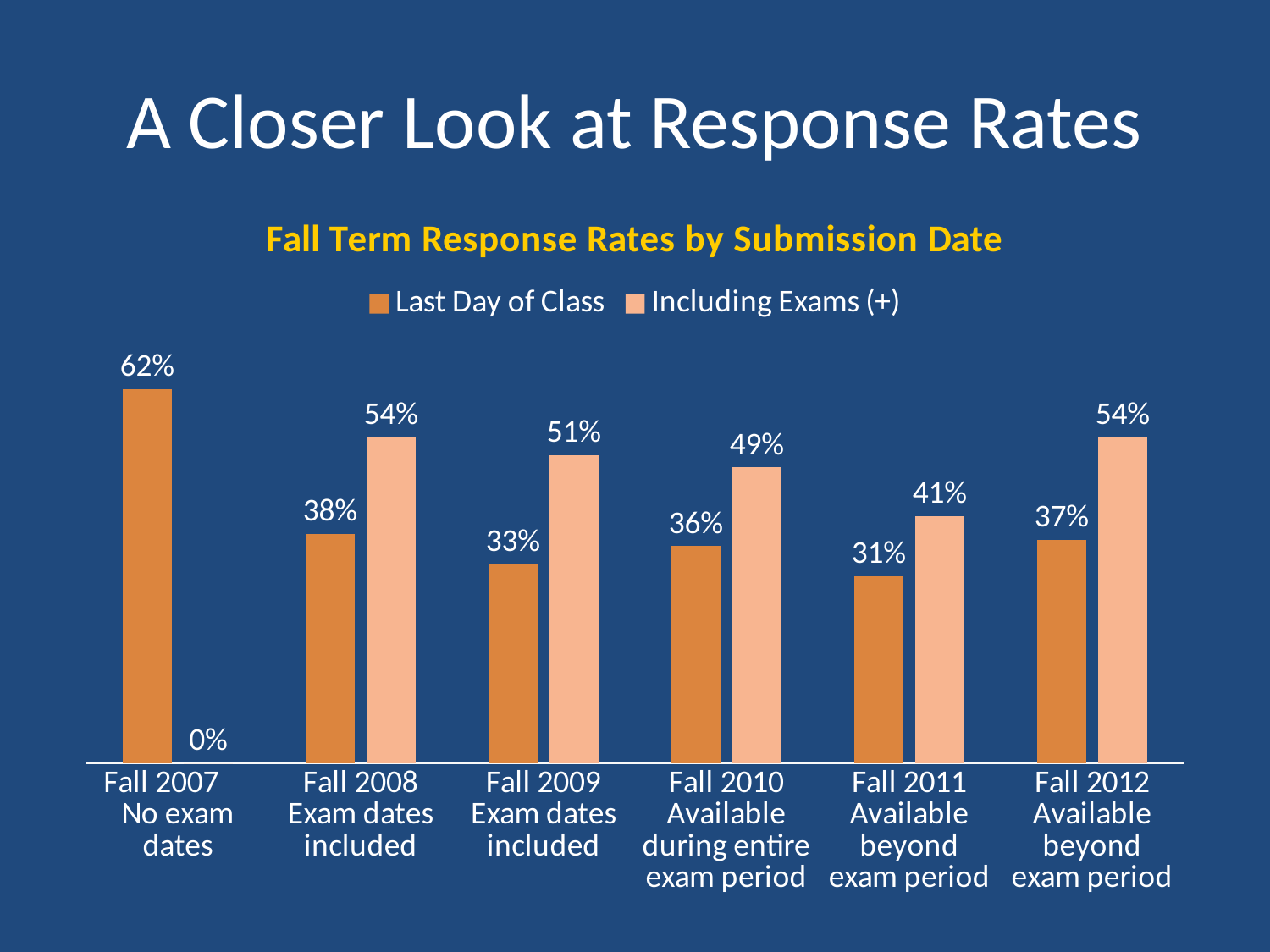
What is the difference between the Including Exams (+) and Last Day of Class response rates for Fall 2009? 18% What is the title of the chart? Fall Term Response Rates by Submission Date What is the Last Day of Class response rate for Fall 2011? 31% Which term has the lowest Last Day of Class response rate? Fall 2011 How many fall terms are shown on the x axis? 6 What is the Last Day of Class response rate for Fall 2007? 62% Which term has the highest Last Day of Class response rate? Fall 2007 What is the Including Exams (+) response rate for Fall 2007? 0% What kind of chart is shown on the slide? Bar chart How many series does the legend list? 2 What is the Including Exams (+) response rate for Fall 2010? 49% Which is larger for Fall 2012: the Last Day of Class rate or the Including Exams (+) rate? Including Exams (+)